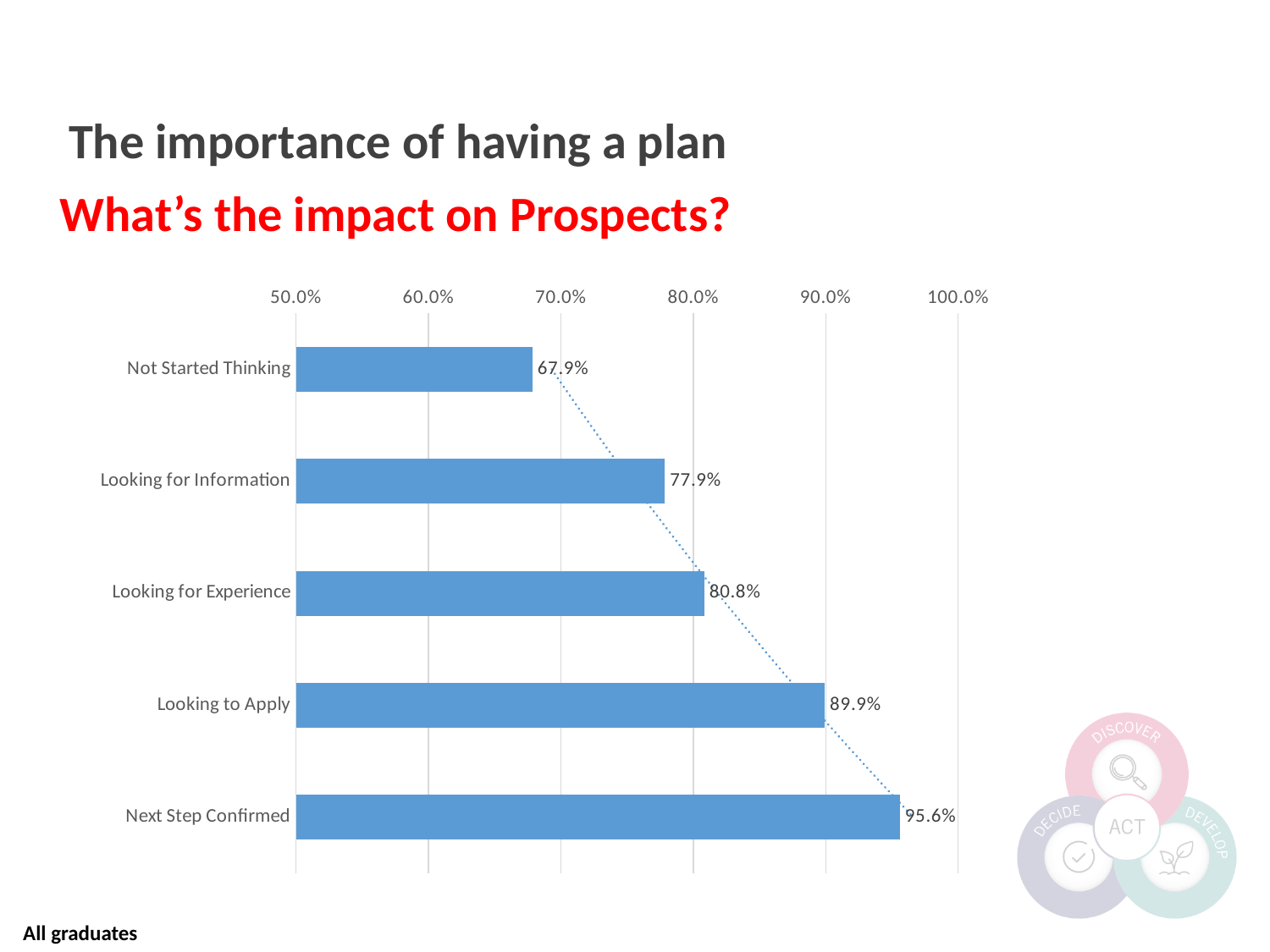
What is the value for Looking for Experience? 80.8% Which is larger, the value for Looking for Experience or the value for Looking to Apply? Looking to Apply Which category has the highest value? Next Step Confirmed How many categories are shown in the chart? 5 Is the value for Looking for Information greater or less than 80.0%? less What kind of chart is shown on the slide? Bar chart What is the value for Looking for Information? 77.9% What is the value for Looking to Apply? 89.9% Which category has the lowest value? Not Started Thinking What is the value for Next Step Confirmed? 95.6% What is the difference between the values for Next Step Confirmed and Not Started Thinking? 27.7% What is the value for Not Started Thinking? 67.9%